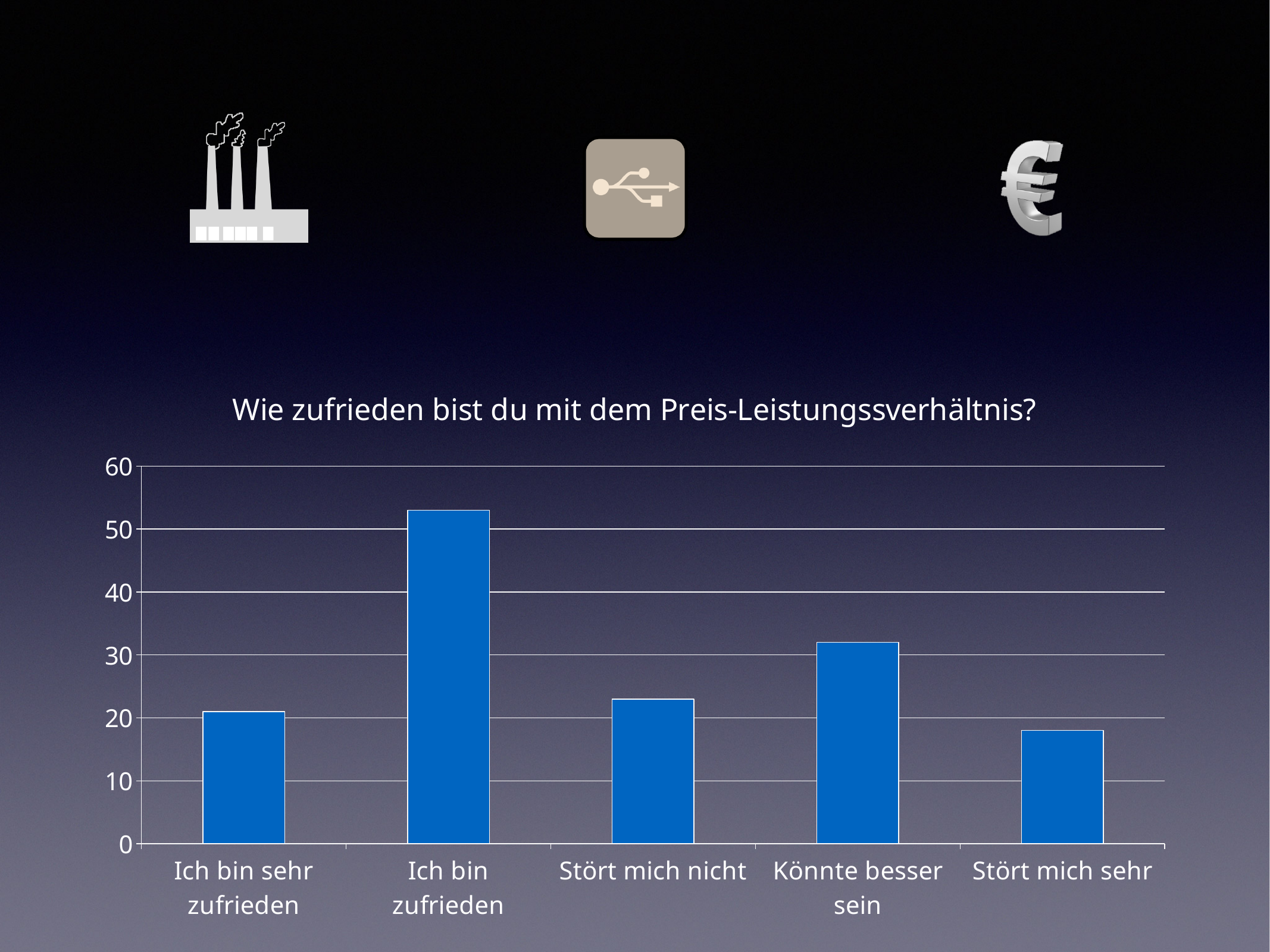
Is the value for "Stört mich sehr" greater or less than 20? less What is the highest value shown on the y axis of the chart? 60 What is the title of the chart? Wie zufrieden bist du mit dem Preis-Leistungssverhältnis? Which category has the highest bar? Ich bin zufrieden Is the value for "Ich bin zufrieden" greater or less than 50? greater Is the value for "Ich bin sehr zufrieden" greater or less than 30? less Which is larger, the value for "Könnte besser sein" or the value for "Stört mich nicht"? Könnte besser sein How many categories are shown on the x axis of the chart? 5 What kind of chart is shown on the slide? bar chart Which is larger, the value for "Ich bin zufrieden" or the value for "Könnte besser sein"? Ich bin zufrieden